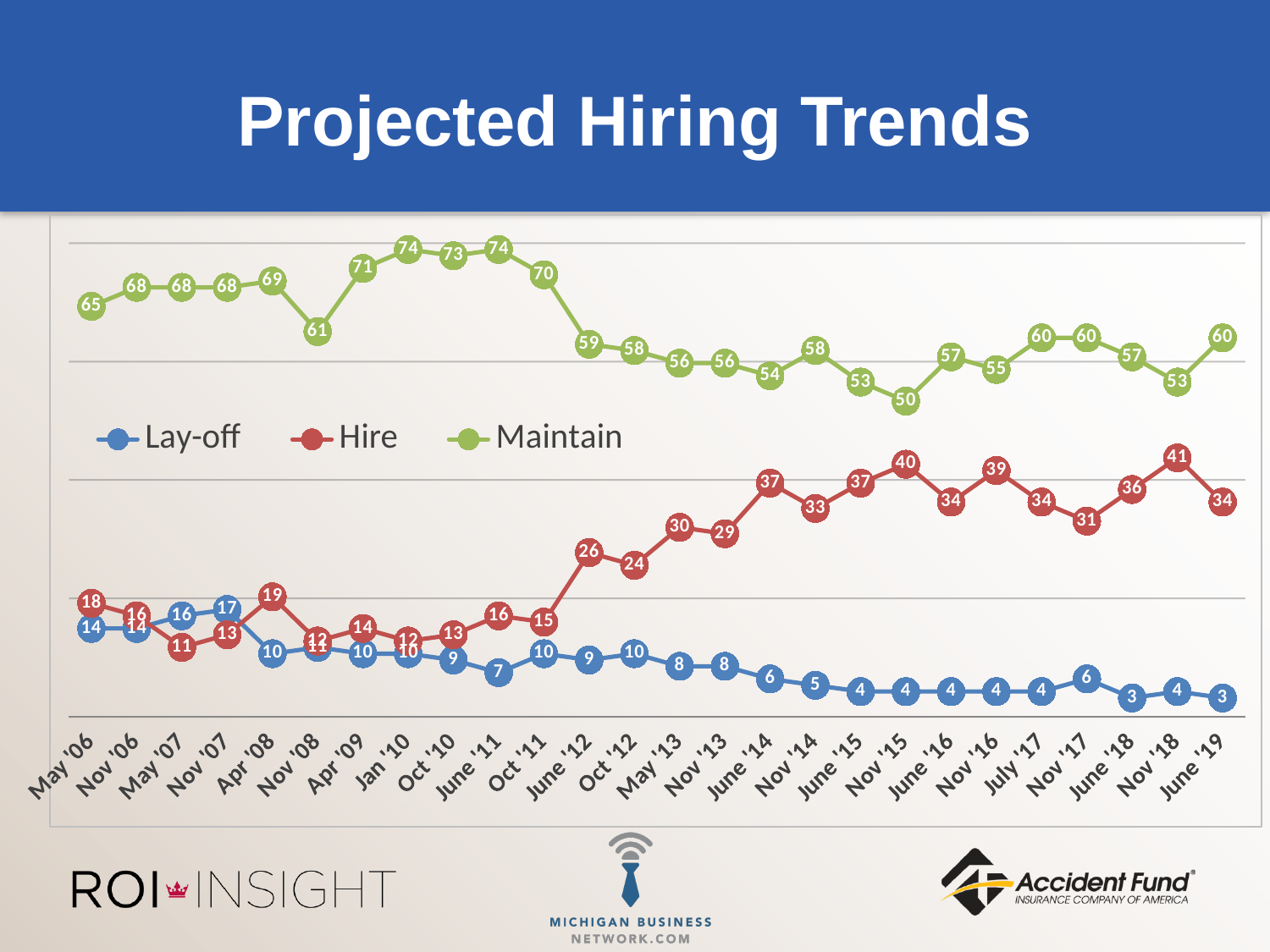
In which period does the Hire series reach its highest value? Nov '18 What are the three series named in the legend? Lay-off, Hire, Maintain What is the Lay-off value for June '19? 3 How many series does the legend list? 3 Which is larger for the Maintain series: the value in Nov '08 or the value in Apr '09? Apr '09 What is the Hire value for Apr '08? 19 What kind of chart is shown on the slide? line chart In which period does the Maintain series reach its lowest value? Nov '15 What is the Maintain value for June '19? 60 What is the Hire value for Nov '18? 41 What is the difference between the Hire value and the Lay-off value in June '19? 31 Does the Lay-off series generally rise or fall from May '06 to June '19? fall